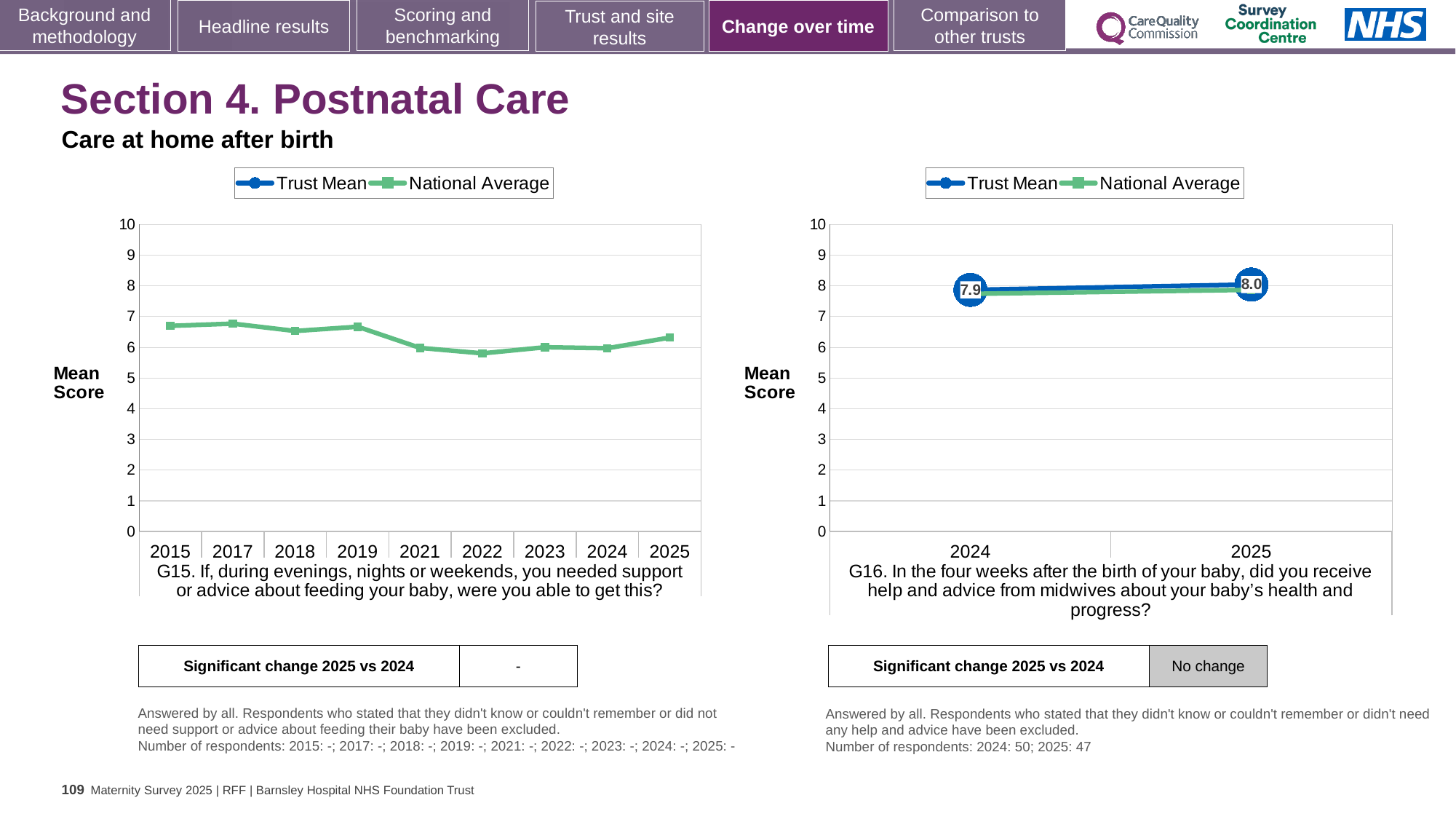
In the G16 chart on the right, how many years are shown on the x axis? 2 How many series does the legend of the G15 chart on the left list? 2 In the G15 chart on the left, how many years are shown on the x axis? 9 In the G15 chart on the left, does the National Average rise or fall between 2019 and 2022? Fall In the G16 chart on the right, what is the Trust Mean for 2025? 8.0 In the G16 chart on the right, by how much did the Trust Mean change from 2024 to 2025? 0.1 What does the 'Significant change 2025 vs 2024' box under the G16 chart on the right say? No change In the G16 chart on the right, which year has the higher Trust Mean, 2024 or 2025? 2025 In the G15 chart on the left, is the National Average for 2015 greater or less than 6? greater What kind of chart is the G15 chart on the left? Line chart In the G15 chart on the left, is the National Average for 2022 greater or less than 7? less In the G16 chart on the right, what is the Trust Mean for 2024? 7.9